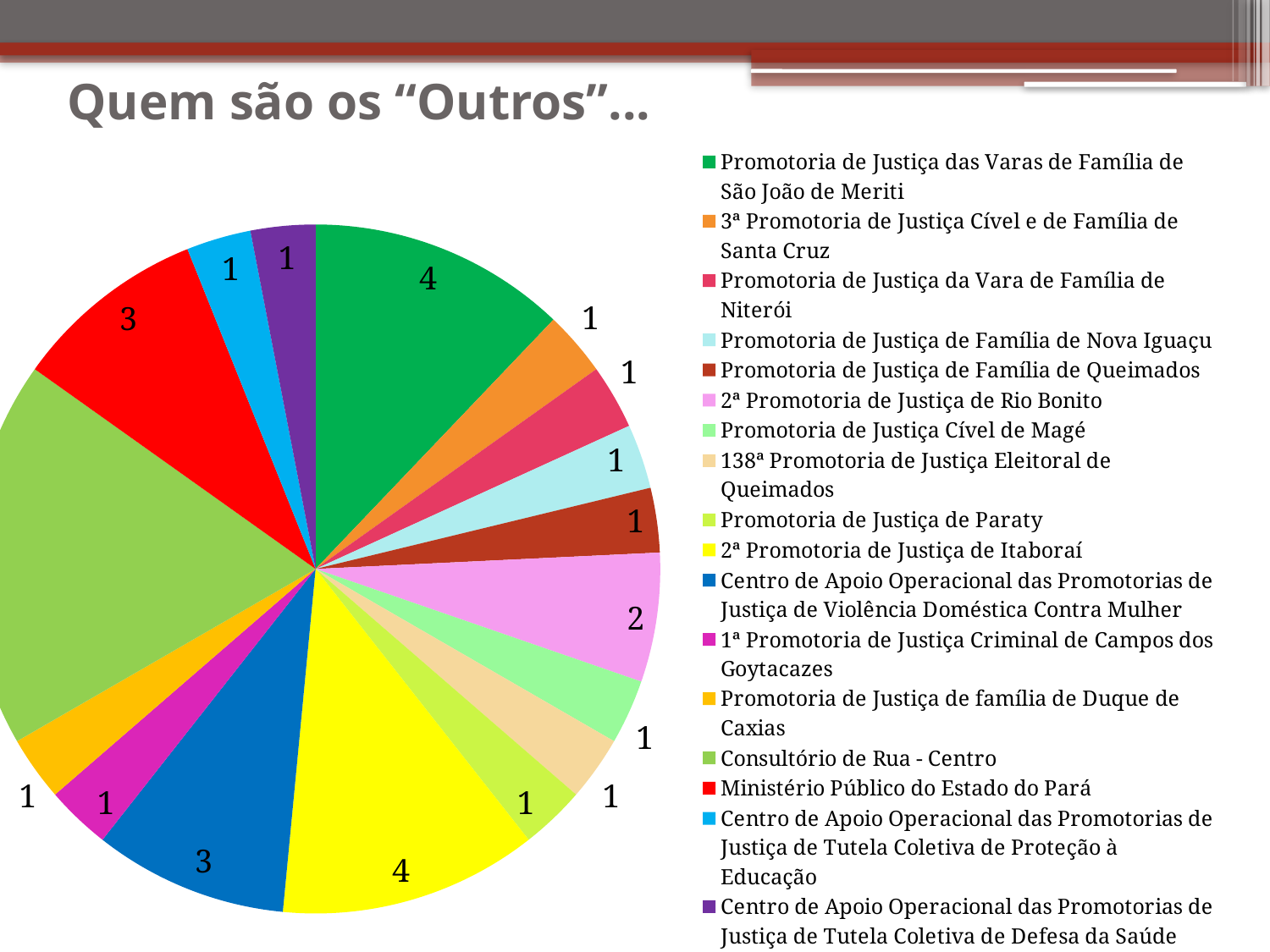
Which category has the largest slice of the pie? Consultório de Rua - Centro What is the value for Centro de Apoio Operacional das Promotorias de Justiça de Violência Doméstica Contra Mulher? 3 What is the value for 2ª Promotoria de Justiça de Rio Bonito? 2 How many categories does the legend list? 17 What is the value for Ministério Público do Estado do Pará? 3 What is the value for 2ª Promotoria de Justiça de Itaboraí? 4 What is the difference between the value for 2ª Promotoria de Justiça de Itaboraí and the value for 2ª Promotoria de Justiça de Rio Bonito? 2 What is the difference between the value for Ministério Público do Estado do Pará and the value for Promotoria de Justiça de Paraty? 2 What kind of chart is shown on the slide? Pie chart Which is larger: the value for Promotoria de Justiça das Varas de Família de São João de Meriti or the value for Ministério Público do Estado do Pará? Promotoria de Justiça das Varas de Família de São João de Meriti What is the value for Promotoria de Justiça das Varas de Família de São João de Meriti? 4 What is the title of the slide? Quem são os "Outros"...